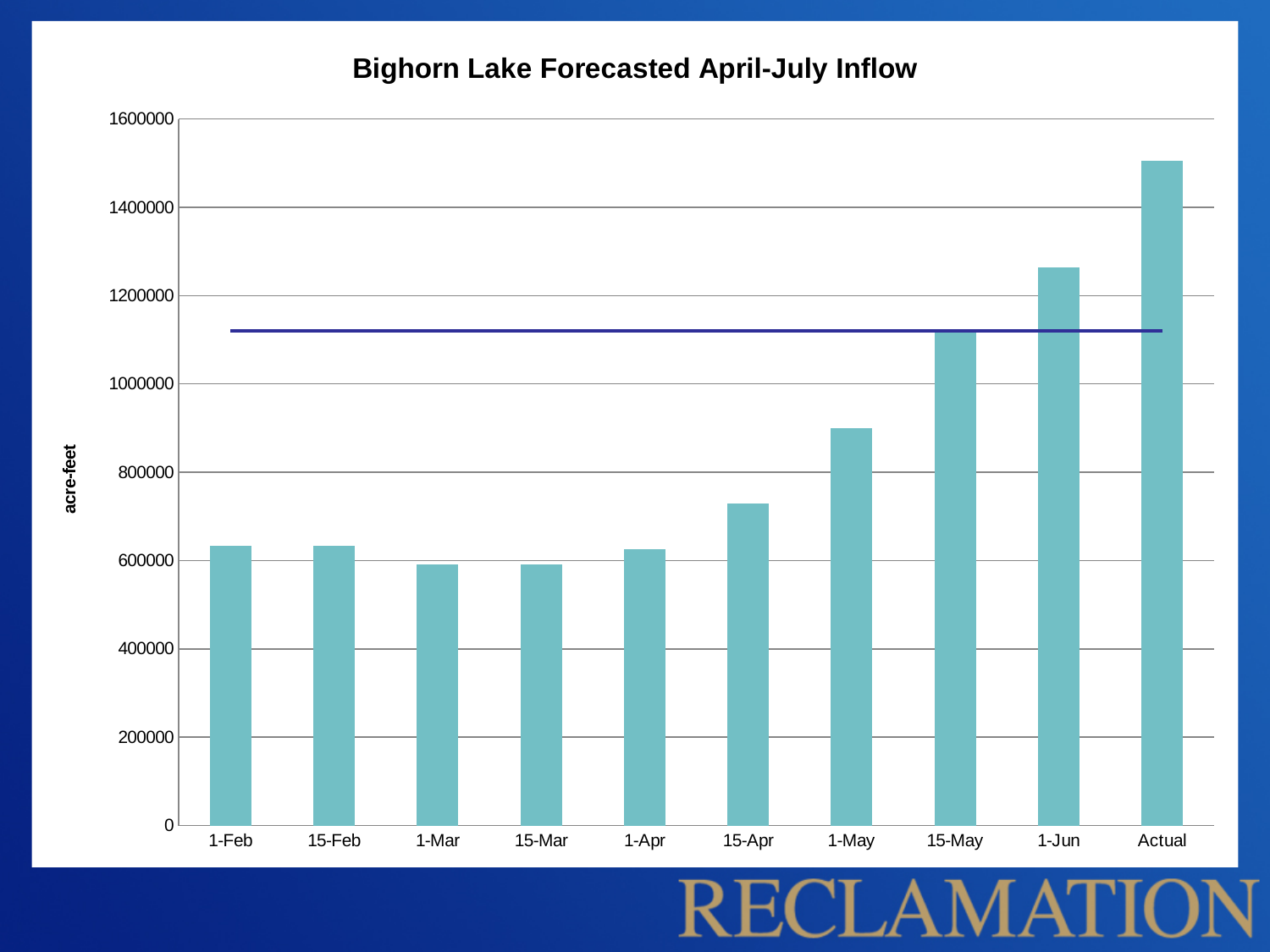
Do the values rise or fall from 1-Apr through Actual along the x axis? rise Is the value for Actual greater or less than 1400000? greater Which is larger, the value for 1-Jun or the value for 1-May? 1-Jun Is the value for 15-May greater or less than 1000000? greater What kind of chart is shown on the slide? bar chart Which category has the highest bar? Actual How many bars (categories) are plotted on the x axis? 10 What is the label on the vertical axis? acre-feet Is the value for 1-Jun greater or less than 1200000? greater What is the title of the chart? Bighorn Lake Forecasted April-July Inflow